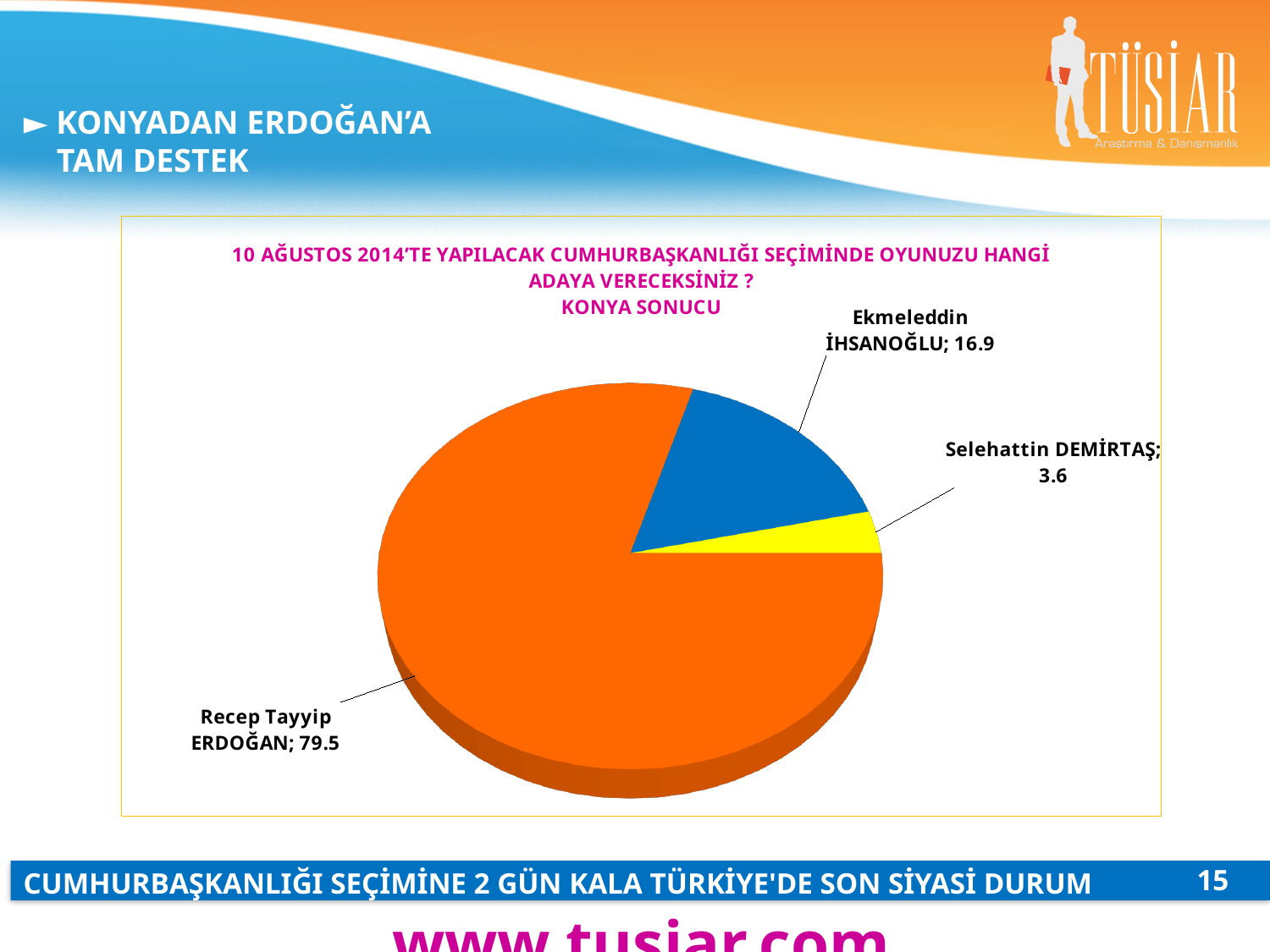
What is the difference between the values for Ekmeleddin İHSANOĞLU and Selehattin DEMİRTAŞ? 13.3 How many slices does the pie chart have? 3 Which candidate has the largest slice of the pie? Recep Tayyip ERDOĞAN What is the difference between the values for Recep Tayyip ERDOĞAN and Ekmeleddin İHSANOĞLU? 62.6 Which candidate has the smallest slice of the pie? Selehattin DEMİRTAŞ Which is larger, the value for Ekmeleddin İHSANOĞLU or the value for Selehattin DEMİRTAŞ? Ekmeleddin İHSANOĞLU What is the value for Ekmeleddin İHSANOĞLU? 16.9 What is the value for Recep Tayyip ERDOĞAN? 79.5 Which city's result does the chart title say it shows? Konya What is the value for Selehattin DEMİRTAŞ? 3.6 What kind of chart is shown on the slide? pie chart What colour is the slice for Recep Tayyip ERDOĞAN? orange